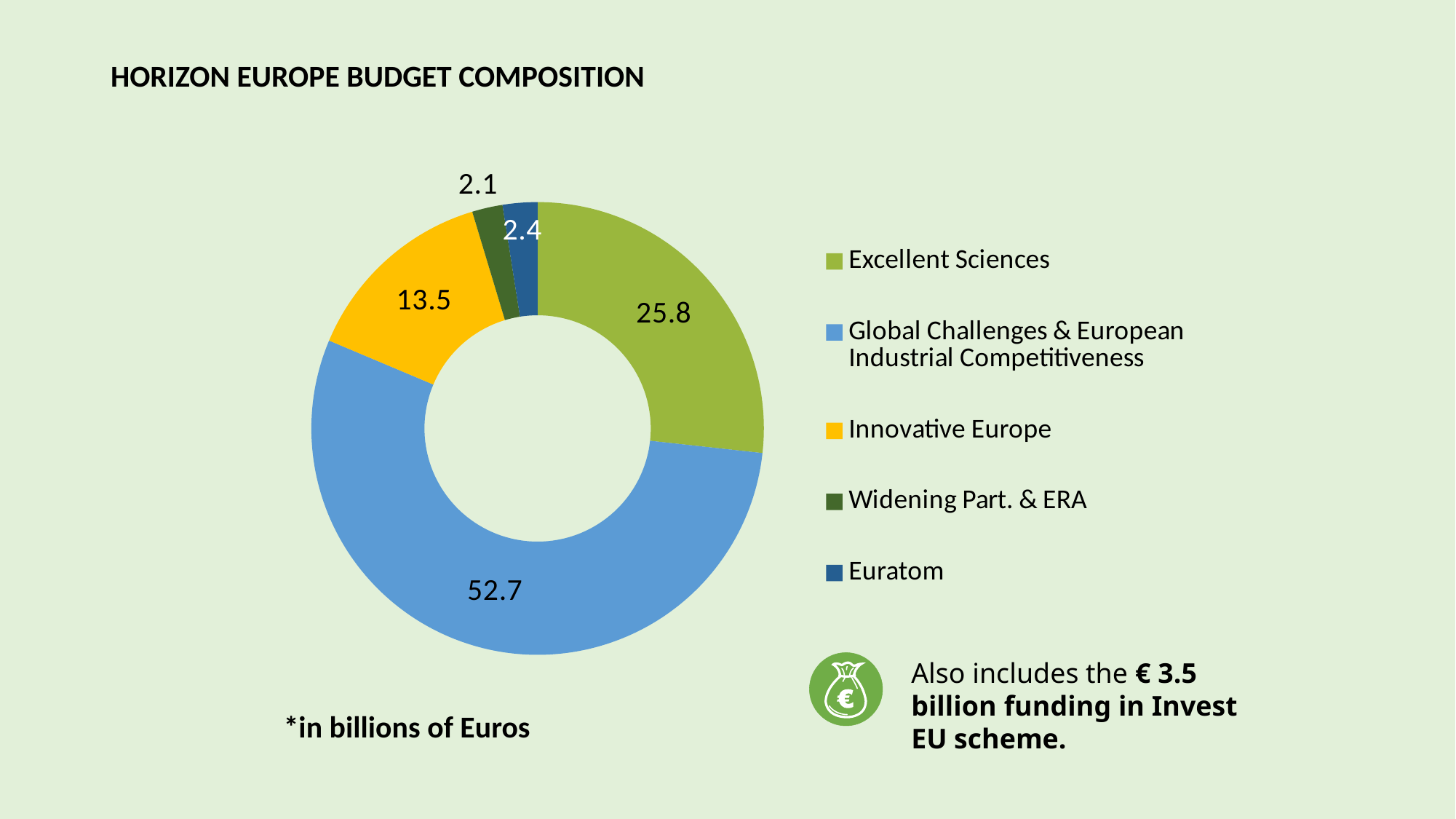
What kind of chart is shown on the slide? Doughnut chart Which category has the largest share of the budget? Global Challenges & European Industrial Competitiveness What is the value for Widening Part. & ERA? 2.1 How many categories does the chart show? 5 Which category has the smallest share of the budget? Widening Part. & ERA What is the value for Euratom? 2.4 What is the value for Excellent Sciences? 25.8 What is the value for Innovative Europe? 13.5 What is the difference between the values for Global Challenges & European Industrial Competitiveness and Excellent Sciences? 26.9 Which is larger, the value for Euratom or the value for Widening Part. & ERA? Euratom What is the title of the chart? HORIZON EUROPE BUDGET COMPOSITION What is the value for Global Challenges & European Industrial Competitiveness? 52.7